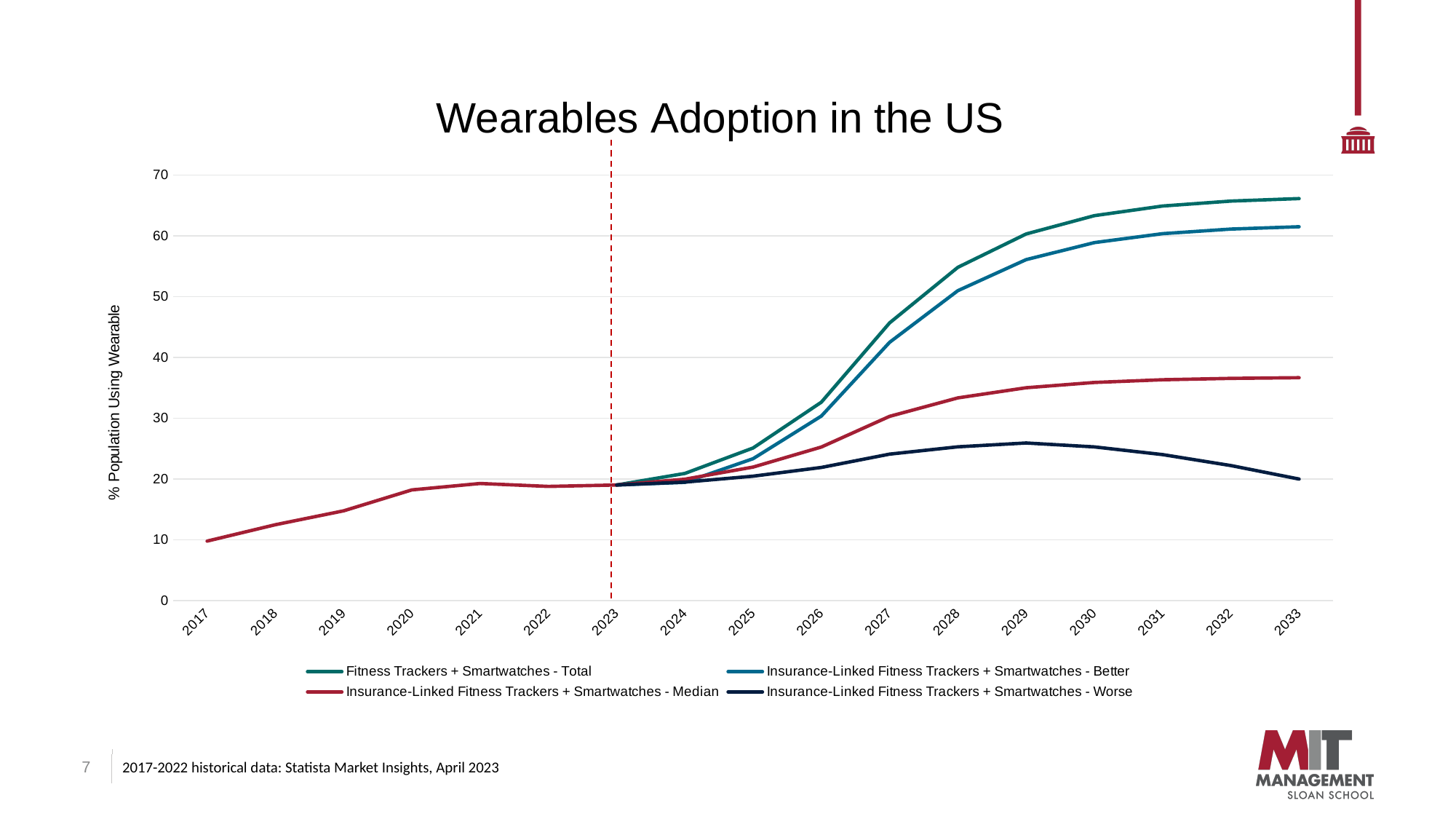
How many series does the legend list? 4 How many years are shown along the x axis? 17 Is the value for Fitness Trackers + Smartwatches - Total in 2033 greater or less than 60? greater Is the value for Insurance-Linked Fitness Trackers + Smartwatches - Worse in 2033 greater or less than 30? less What is the title of the chart? Wearables Adoption in the US Is the value in 2017 greater or less than 20? less Which series has the highest value in 2033? Fitness Trackers + Smartwatches - Total Which series has the lowest value in 2033? Insurance-Linked Fitness Trackers + Smartwatches - Worse Does the Insurance-Linked Fitness Trackers + Smartwatches - Worse series rise or fall from 2029 to 2033? fall At which year is the red dashed vertical line placed? 2023 In 2030, which is larger: Insurance-Linked Fitness Trackers + Smartwatches - Better or Insurance-Linked Fitness Trackers + Smartwatches - Median? Insurance-Linked Fitness Trackers + Smartwatches - Better What kind of chart is shown on the slide? line chart